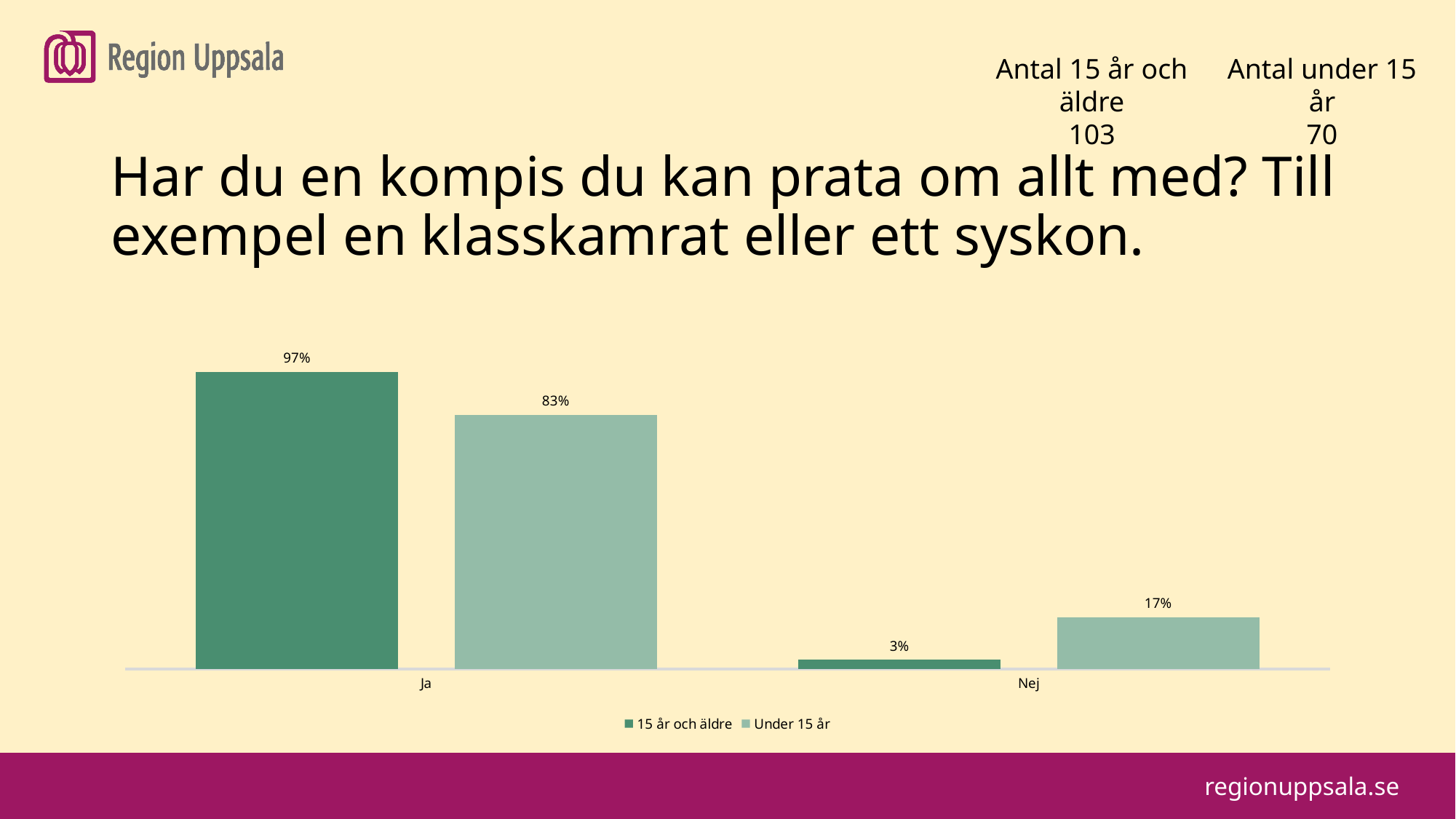
What is the difference between the Nej values for Under 15 år and 15 år och äldre? 14 percentage points What percentage of respondents aged 15 år och äldre answered Nej? 3% What percentage of respondents Under 15 år answered Nej? 17% How many series does the legend list? 2 What kind of chart is shown on the slide? Bar chart For the Nej category, which group has the larger value: 15 år och äldre or Under 15 år? Under 15 år What percentage of respondents Under 15 år answered Ja? 83% Which bar in the chart has the lowest value? Nej, 15 år och äldre What percentage of respondents aged 15 år och äldre answered Ja? 97% Which bar in the chart has the highest value? Ja, 15 år och äldre What is the difference between the Ja values for 15 år och äldre and Under 15 år? 14 percentage points How many answer categories are shown on the x axis? 2